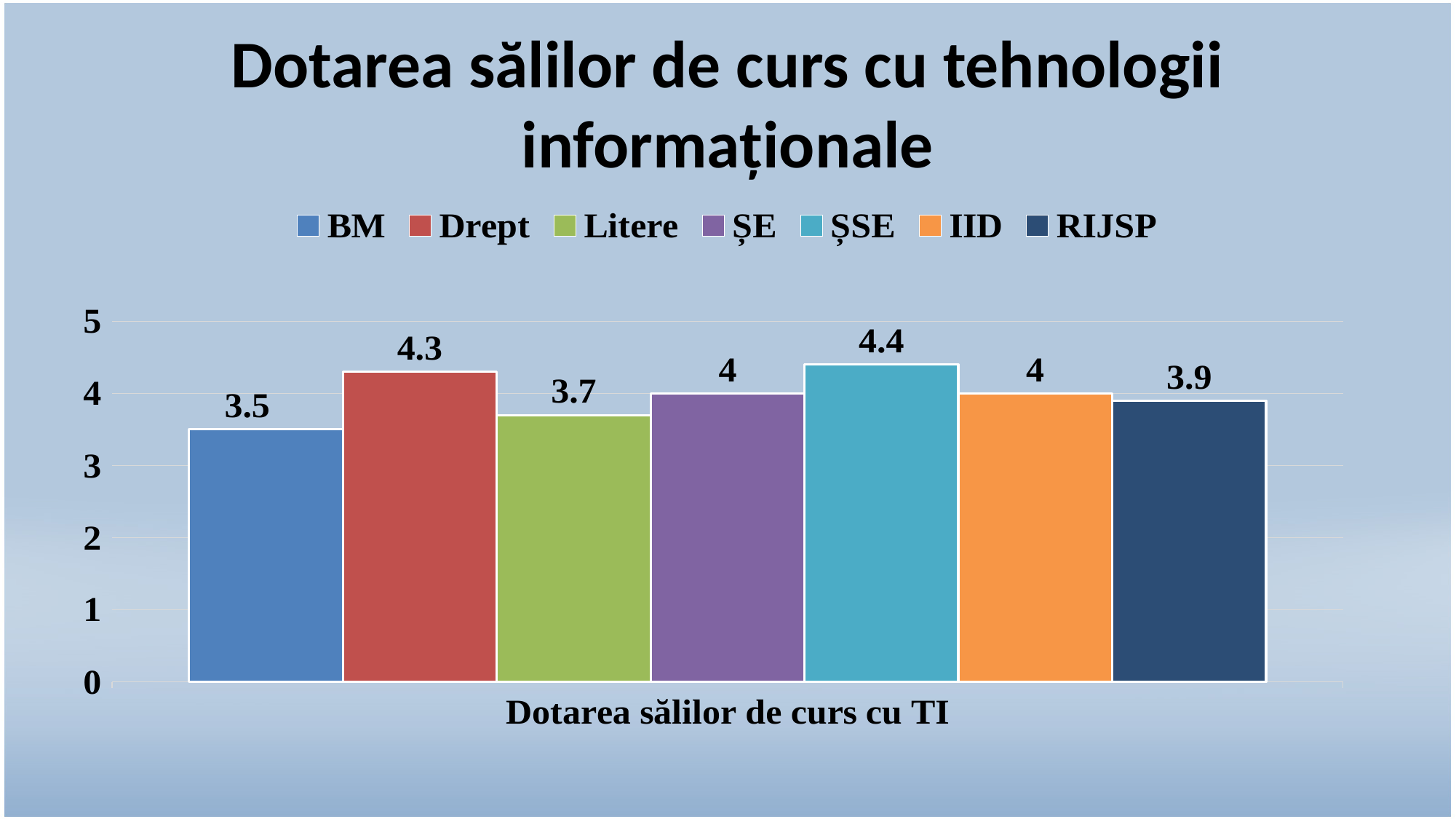
Which series has the highest value? ȘSE Is the value for IID greater or less than 3? greater What is the value for RIJSP? 3.9 What kind of chart is shown on the slide? bar chart What is the difference between the values for ȘSE and BM? 0.9 How many series does the legend list? 7 What is the value for BM? 3.5 Which is larger, the value for Drept or the value for Litere? Drept What is the title of the chart? Dotarea sălilor de curs cu tehnologii informaționale Which series has the lowest value? BM What is the value for Drept? 4.3 What is the value for Litere? 3.7